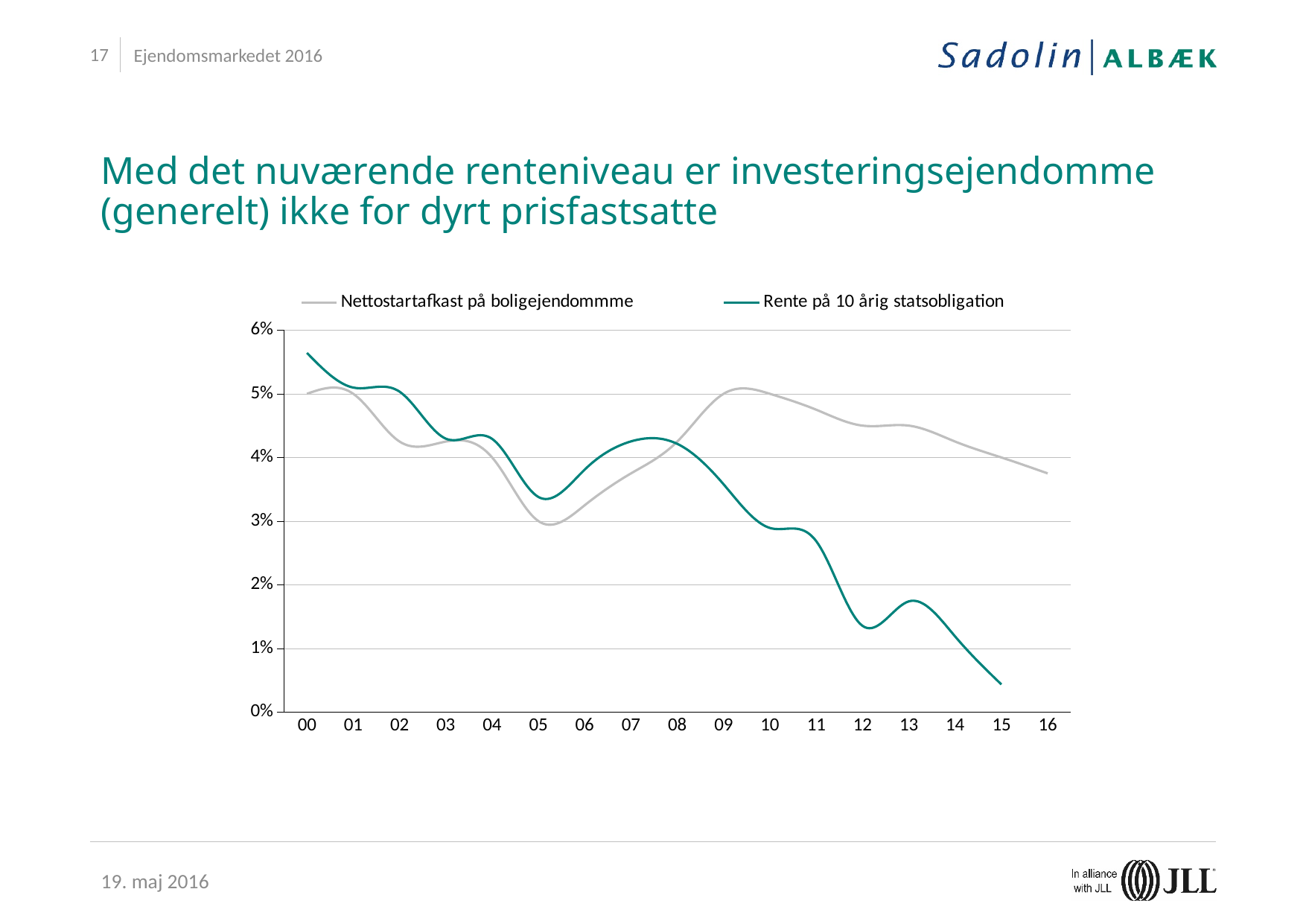
Is the value for 'Nettostartafkast på boligejendommme' in 09 greater or less than 4%? greater Is the value for 'Rente på 10 årig statsobligation' in 15 greater or less than 1%? less How many series does the legend list? 2 In 00, which series has the higher value: 'Nettostartafkast på boligejendommme' or 'Rente på 10 årig statsobligation'? Rente på 10 årig statsobligation Is the value for 'Nettostartafkast på boligejendommme' in 16 greater or less than 4%? less In which year is 'Rente på 10 årig statsobligation' at its lowest? 15 How many years are labelled on the x axis? 17 What kind of chart is shown on the slide? line chart In 15, which series has the higher value: 'Nettostartafkast på boligejendommme' or 'Rente på 10 årig statsobligation'? Nettostartafkast på boligejendommme Does 'Rente på 10 årig statsobligation' rise or fall overall from 00 to 15? fall